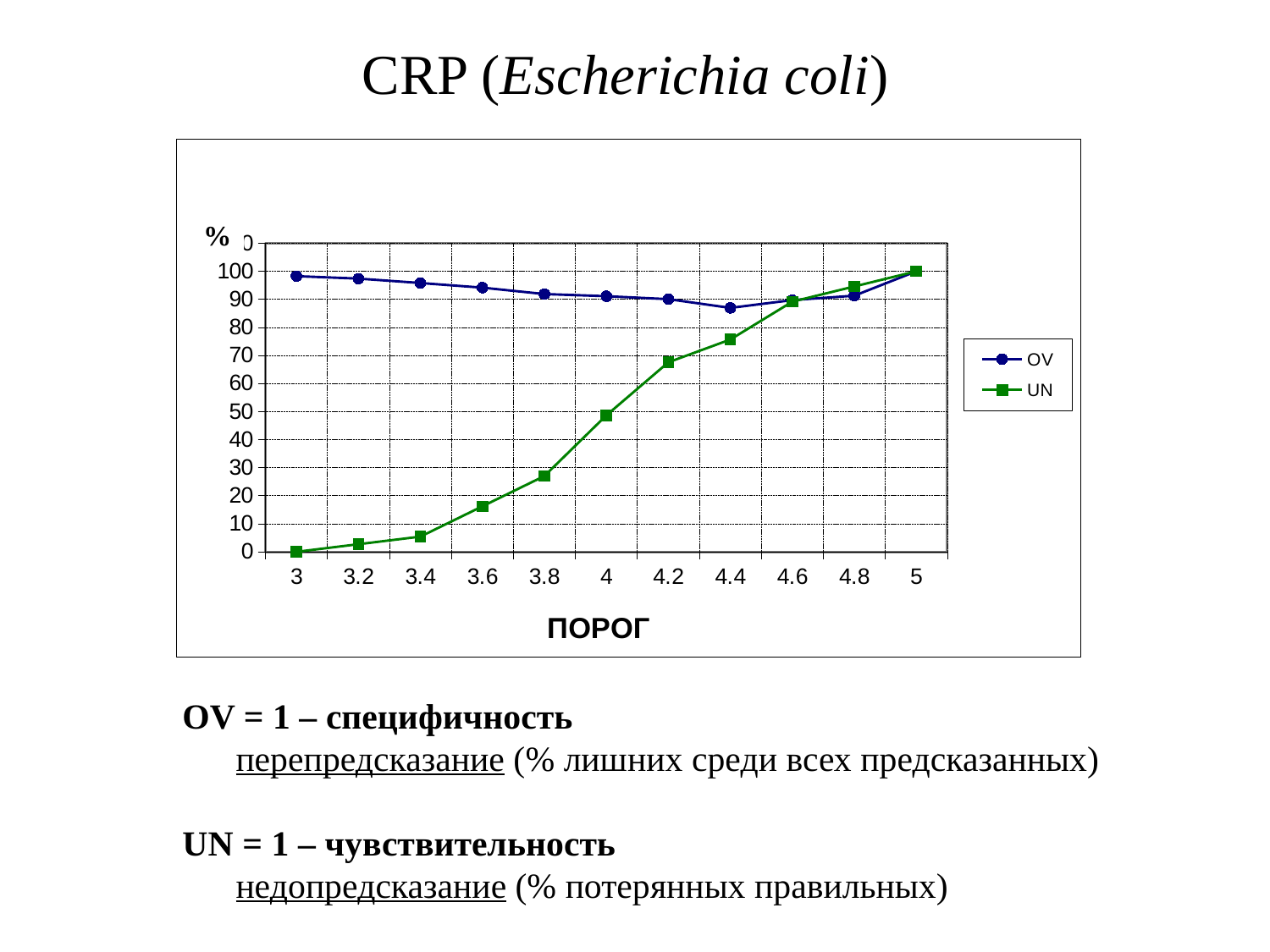
Does the UN series rise or fall as the threshold increases from 3 to 5? rise What are the names of the series in the legend? OV and UN At threshold 3.8, which series has the larger value, OV or UN? OV How many series does the legend list? 2 Is the value of OV at threshold 4.4 greater or less than 80? greater What is the value of UN at threshold 5? 100 How many points are plotted along the x axis for each series? 11 What is the value of UN at threshold 3? 0 What kind of chart is shown on the slide? line chart Is the value of UN at threshold 4 greater or less than 40? greater What is the label of the x axis? ПОРОГ At which threshold does the UN series reach its lowest value? 3